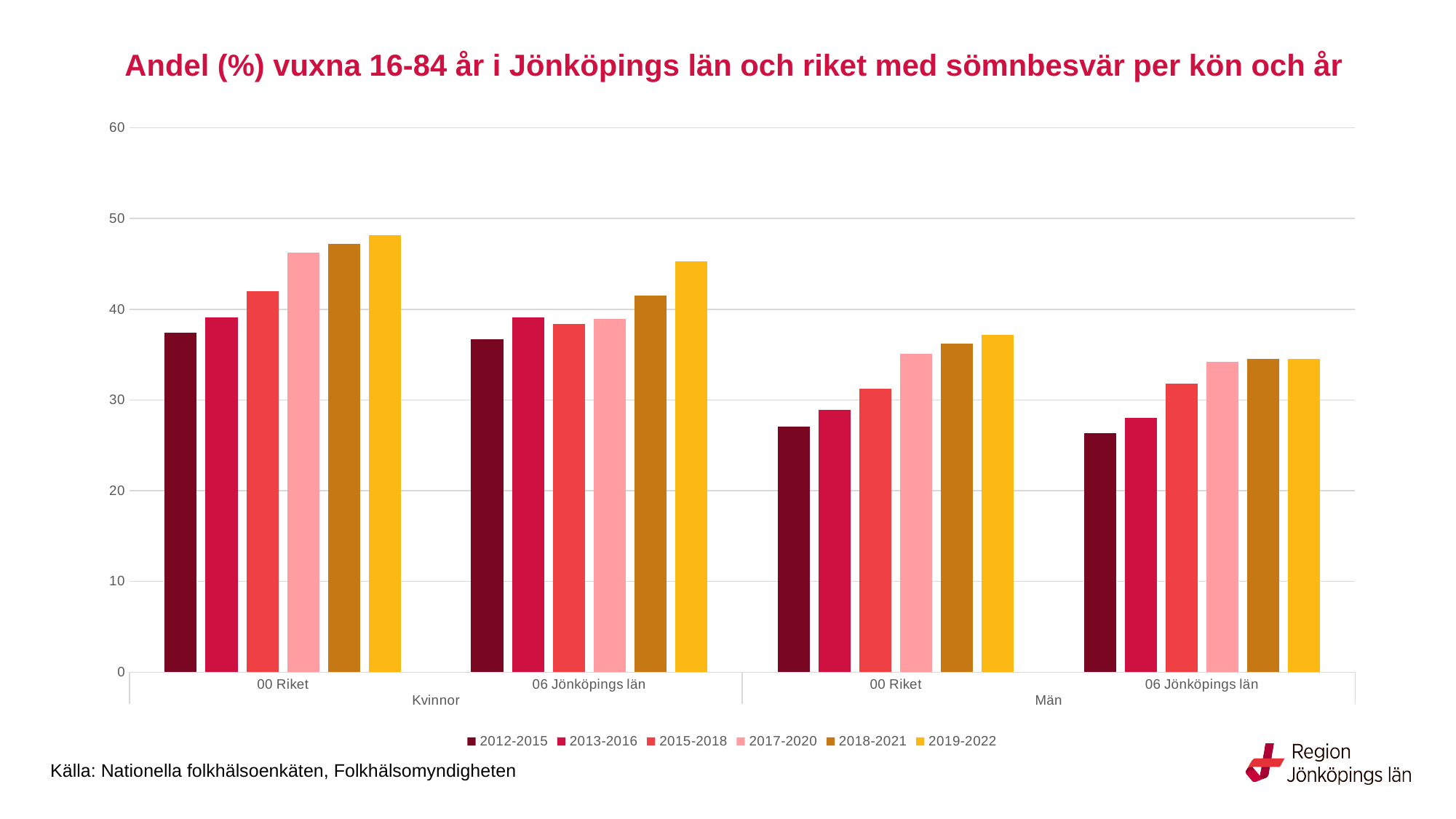
Is the value for 2017-2020 for 00 Riket among Män greater or less than 30? greater How many groups of bars are plotted along the x axis? 4 Is the value for 2012-2015 for 06 Jönköpings län among Män greater or less than 30? less For 2012-2015 for 00 Riket, which is larger: Kvinnor or Män? Kvinnor Which period has the lowest value for 06 Jönköpings län among Män? 2012-2015 For 2019-2022 among Kvinnor, which is larger: 00 Riket or 06 Jönköpings län? 00 Riket What kind of chart is shown on the slide? Bar chart Do the values for 00 Riket among Män rise or fall from 2012-2015 to 2019-2022? rise Which period has the highest value for 00 Riket among Kvinnor? 2019-2022 Is the value for 2019-2022 for 00 Riket among Kvinnor greater or less than 40? greater What source is cited below the chart? Nationella folkhälsoenkäten, Folkhälsomyndigheten How many series does the legend list? 6